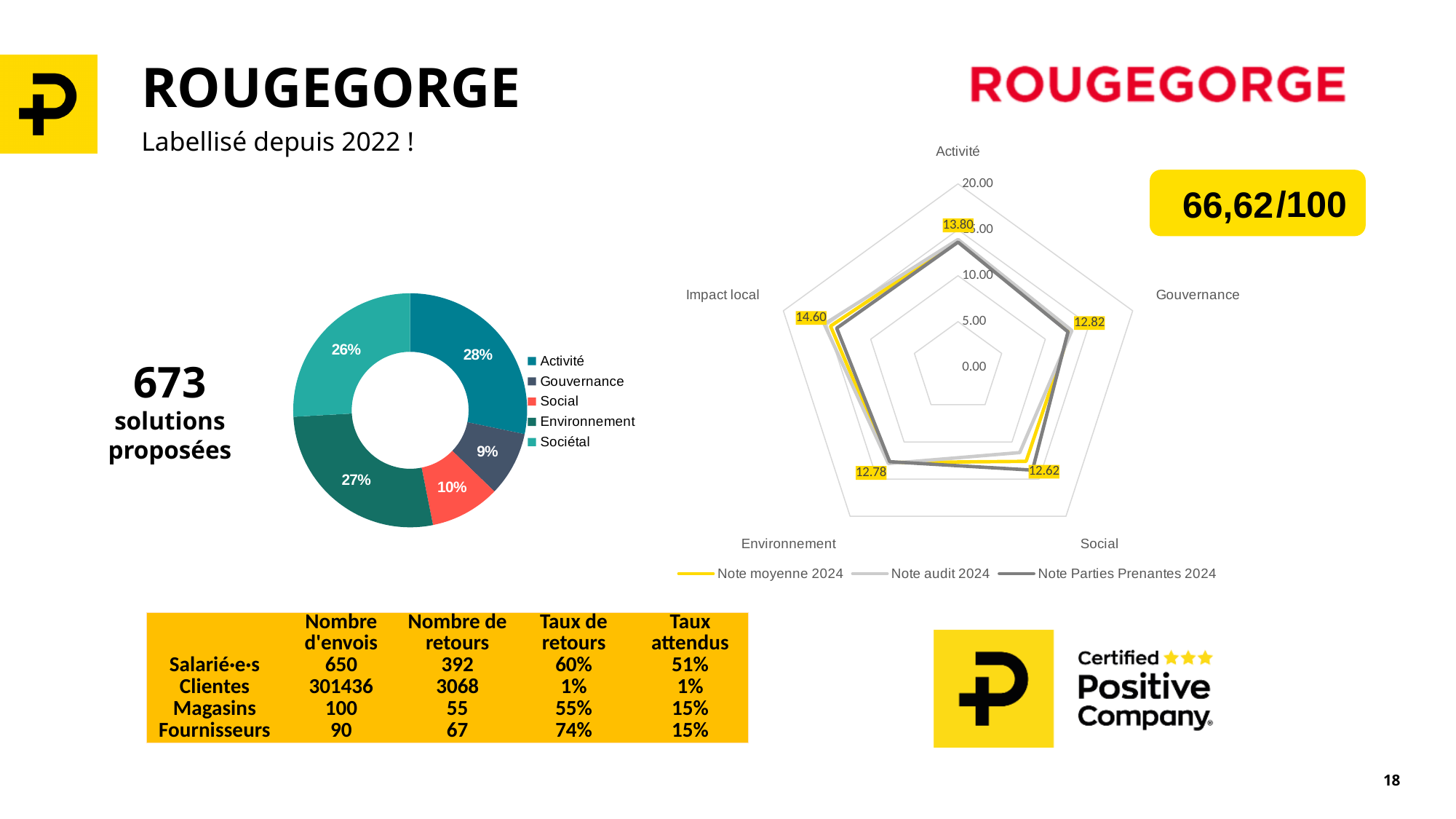
On the donut chart on the left, how many categories does the legend list? 5 On the radar chart on the right, which axis has the highest labelled value? Impact local On the donut chart on the left, which category has the largest share? Activité What kind of chart is the chart on the left of the slide? Donut (pie) chart On the radar chart on the right, what is the labelled value for Impact local? 14.60 On the donut chart on the left, what share does Activité have? 28% On the radar chart on the right, is the labelled value for Social greater or less than 10.00? greater On the donut chart on the left, what share does Gouvernance have? 9% On the radar chart on the right, what is the labelled value for Activité? 13.80 On the radar chart on the right, how many series does the legend list? 3 On the donut chart on the left, what is the difference between the shares of Environnement and Social? 17% On the donut chart on the left, which category has the smallest share? Gouvernance